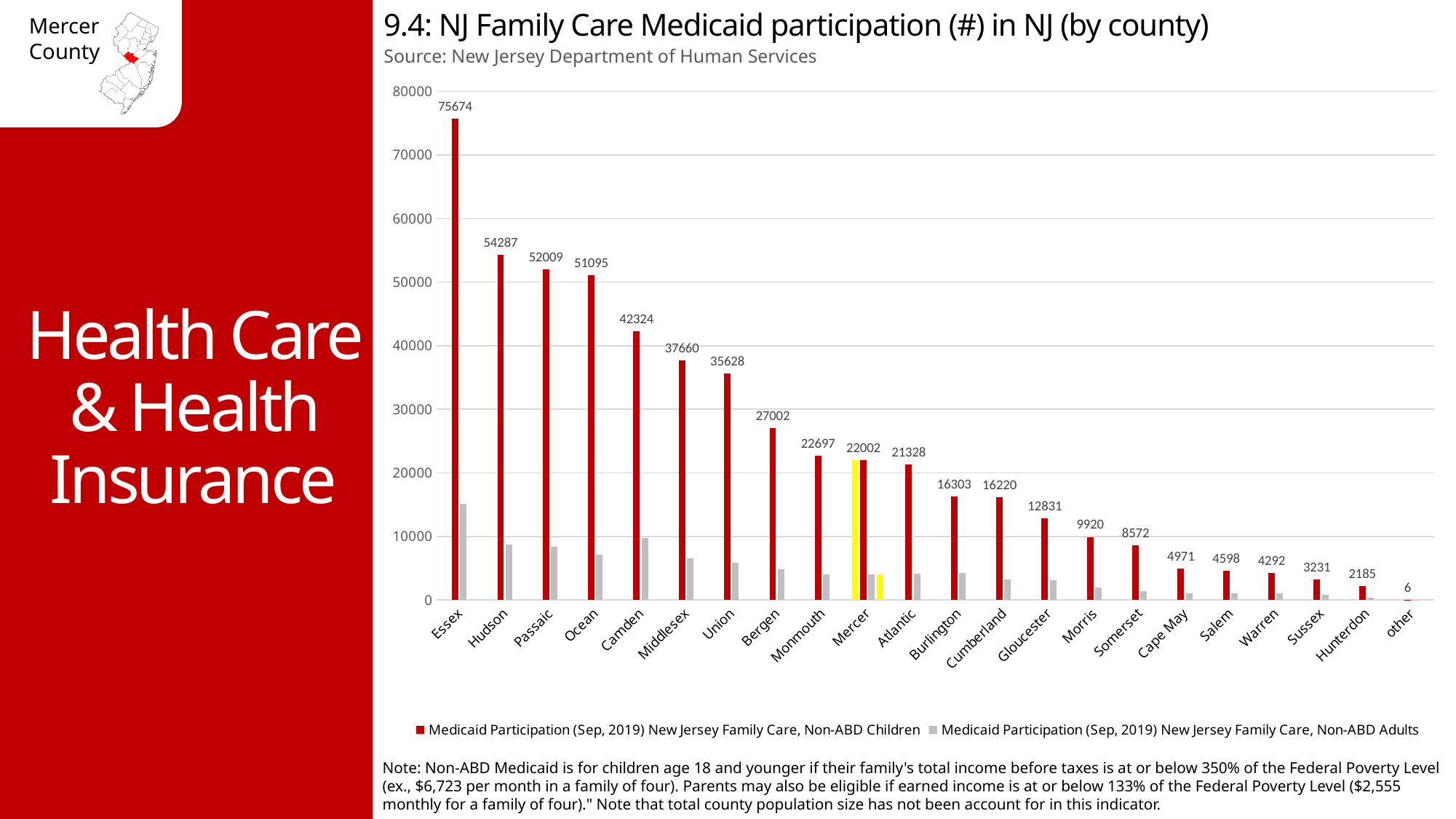
What kind of chart is shown on the slide? Bar chart What is the difference between the Non-ABD Children values for Essex and Hudson? 21387 Which county has the lowest Non-ABD Children Medicaid participation (excluding 'other')? Hunterdon How many categories are shown on the x axis? 22 Is the Non-ABD Adults value for Hudson greater or less than 10000? less Is the Non-ABD Adults value for Essex greater or less than 10000? greater Which has a larger Non-ABD Children value, Union or Bergen? Union Which county has the highest Non-ABD Children Medicaid participation? Essex What is the Non-ABD Children Medicaid participation value for Camden county? 42324 Which county's bars are highlighted in yellow? Mercer What is the Non-ABD Children Medicaid participation value for Mercer county? 22002 How many series does the legend list? 2